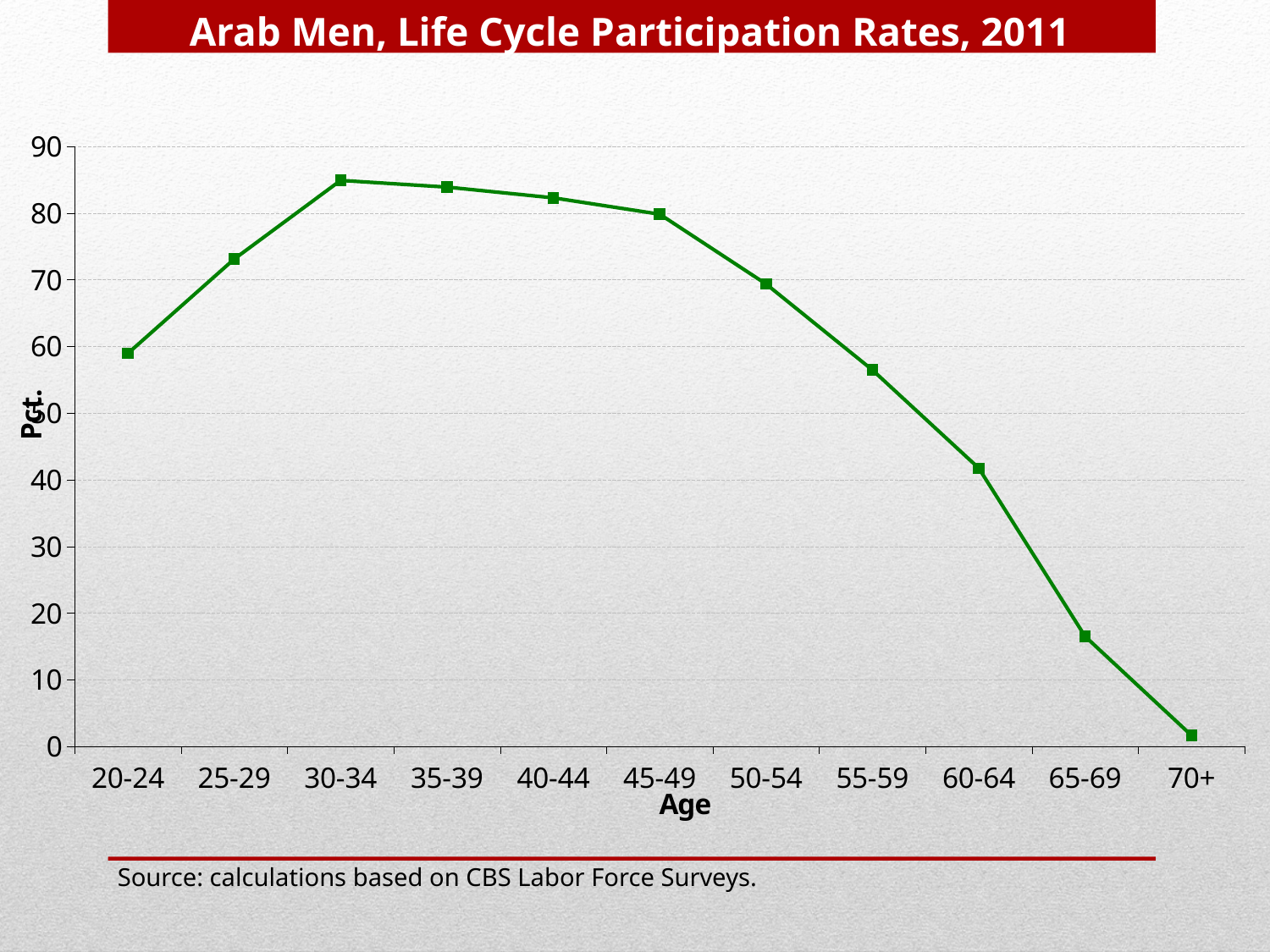
How many age groups are plotted along the x axis? 11 Which age group has the lowest participation rate? 70+ Which age group has a higher participation rate, 50-54 or 55-59? 50-54 Is the value for the 25-29 age group greater or less than 70? greater What kind of chart is shown on the slide? line chart What is the label of the y axis? Pct. Is the value for the 60-64 age group greater or less than 40? greater Is the value for the 65-69 age group greater or less than 20? less What is the title of the chart? Arab Men, Life Cycle Participation Rates, 2011 Do the participation rates rise or fall from the 45-49 age group to the 70+ age group? fall Which age group has the highest participation rate? 30-34